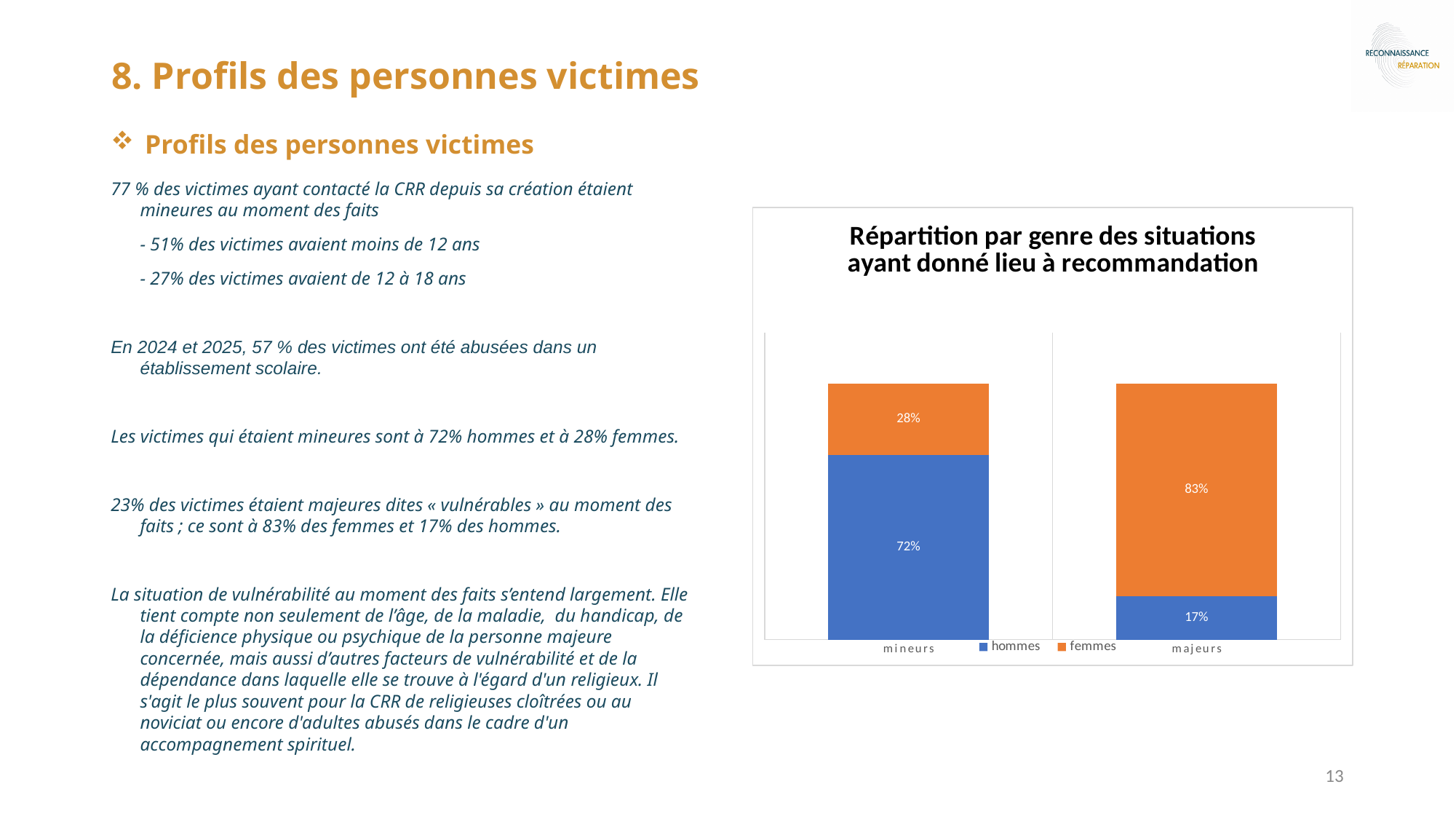
What is the value for hommes in the mineurs bar? 72% How many categories are shown on the x axis? 2 What is the total of the mineurs stacked bar? 100% Which category has the higher value for hommes, mineurs or majeurs? mineurs What is the value for femmes in the majeurs bar? 83% What is the difference between the hommes and femmes values in the mineurs bar? 44% Which category has the higher value for femmes, mineurs or majeurs? majeurs How many series does the legend list? 2 What is the value for hommes in the majeurs bar? 17% What is the value for femmes in the mineurs bar? 28% What is the difference between the femmes value for majeurs and the femmes value for mineurs? 55% What kind of chart is shown on the slide? stacked bar chart